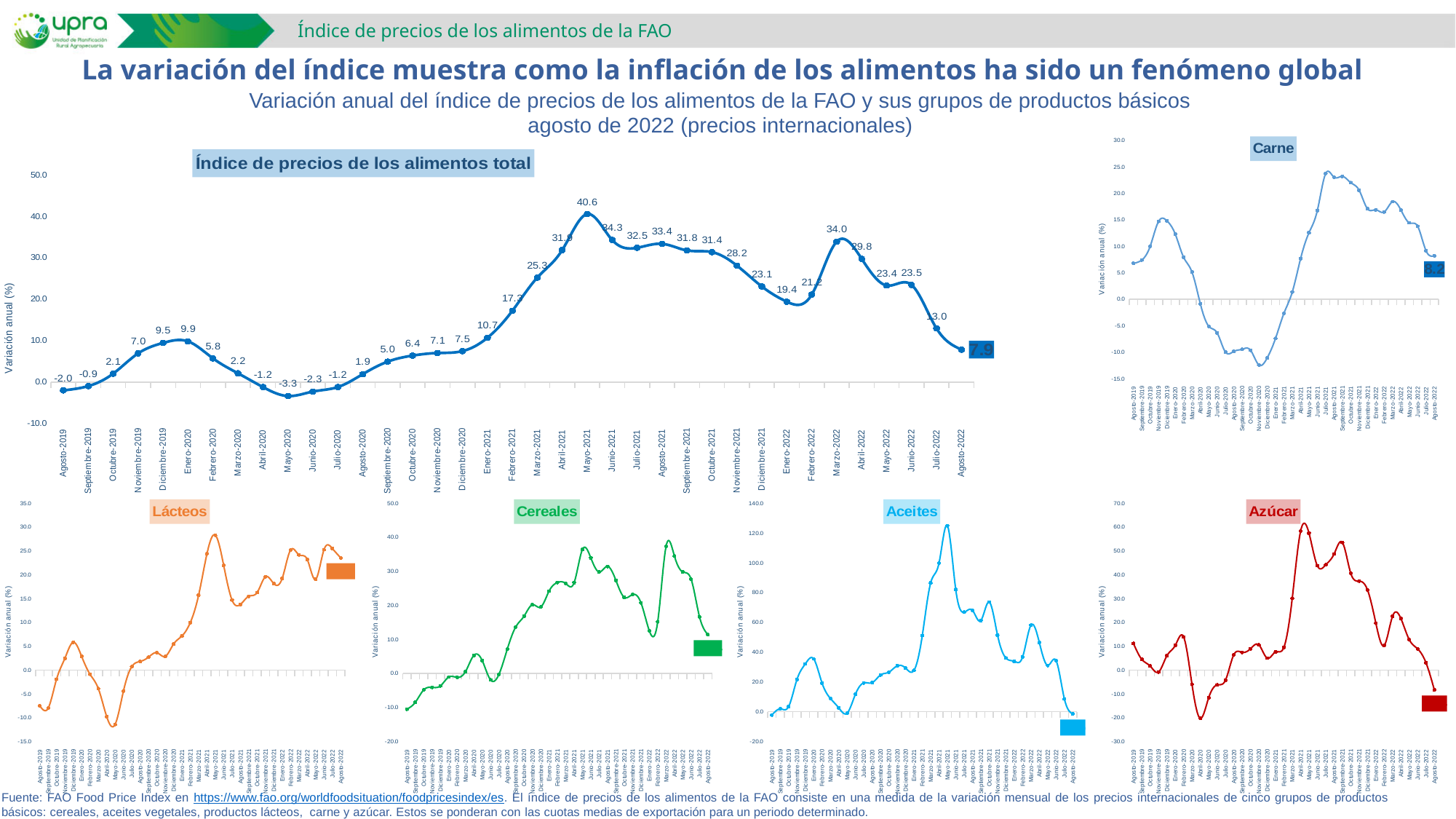
In the 'Carne' chart, is the value for Agosto-2021 greater or less than 20.0? greater What kind of chart is the 'Índice de precios de los alimentos total' chart? Line chart In the 'Índice de precios de los alimentos total' chart, how many monthly data points are plotted? 37 In the 'Índice de precios de los alimentos total' chart, what is the difference between the values for Mayo-2021 and Agosto-2022? 32.7 In the 'Índice de precios de los alimentos total' chart, which month has the highest value? Mayo-2021 In the 'Aceites' chart, is the value for Mayo-2021 greater or less than 100.0? greater In the 'Índice de precios de los alimentos total' chart, which is larger, the value for Marzo-2022 or Abril-2022? Marzo-2022 Which of the small charts at the bottom of the slide is drawn in red? Azúcar In the 'Índice de precios de los alimentos total' chart, what is the value for Agosto-2022? 7.9 In the 'Índice de precios de los alimentos total' chart, which month has the lowest value? Mayo-2020 In the 'Índice de precios de los alimentos total' chart, do the values rise or fall from Enero-2022 to Marzo-2022? Rise In the 'Índice de precios de los alimentos total' chart, what is the value for Mayo-2021? 40.6